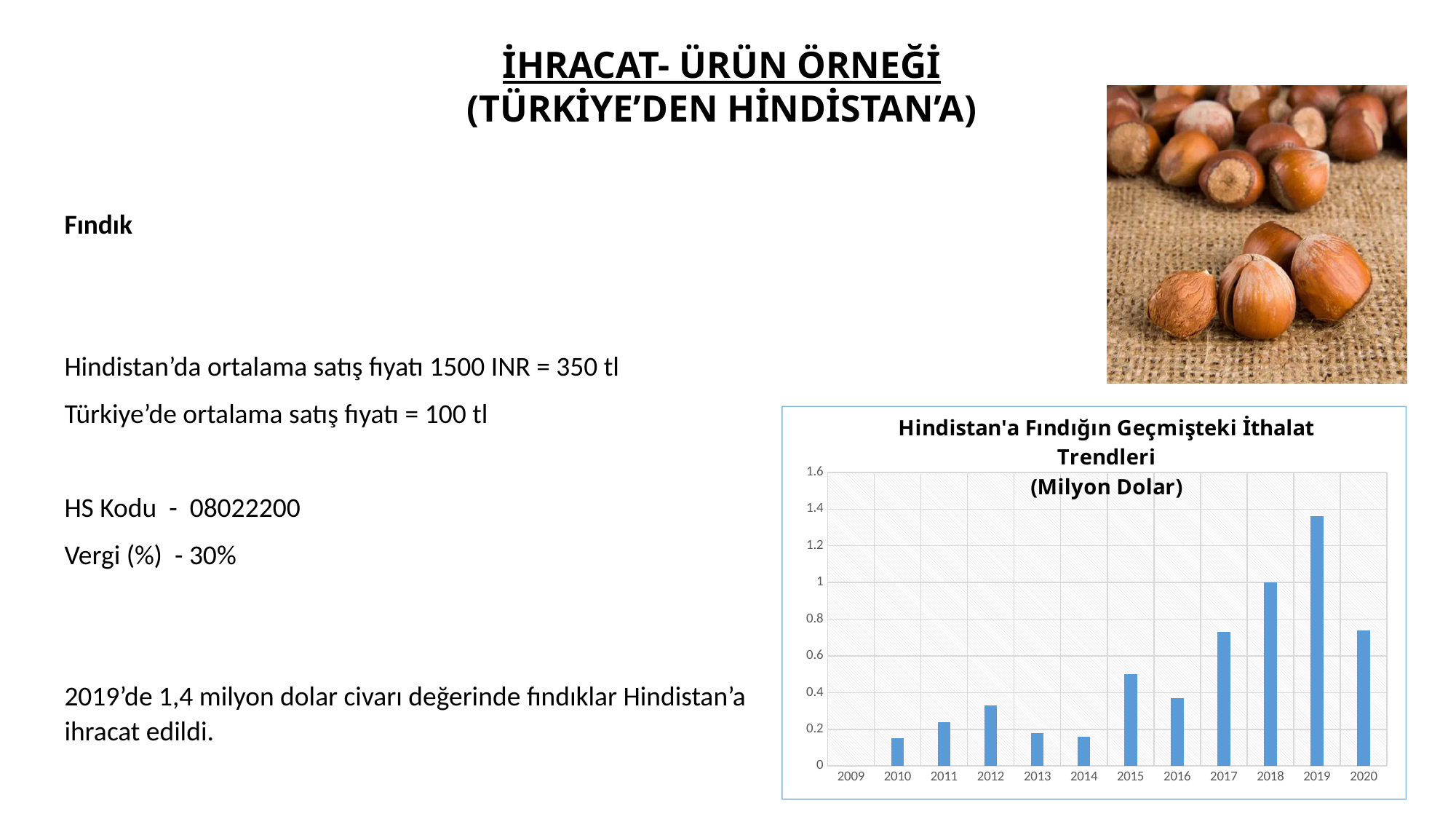
Is the value for 2016 greater or less than 0.4? less Which year has the larger value, 2011 or 2012? 2012 Which year has the highest bar in the chart? 2019 Is the value for 2019 greater or less than 1.2? greater Do the values rise or fall from 2014 to 2019? rise What kind of chart is shown on the slide? bar chart Is the value for 2013 greater or less than 0.2? less How many years are shown on the x axis of the chart? 12 What is the title of the chart? Hindistan'a Fındığın Geçmişteki İthalat Trendleri (Milyon Dolar) Which year has the larger value, 2016 or 2017? 2017 Which year has the larger value, 2018 or 2019? 2019